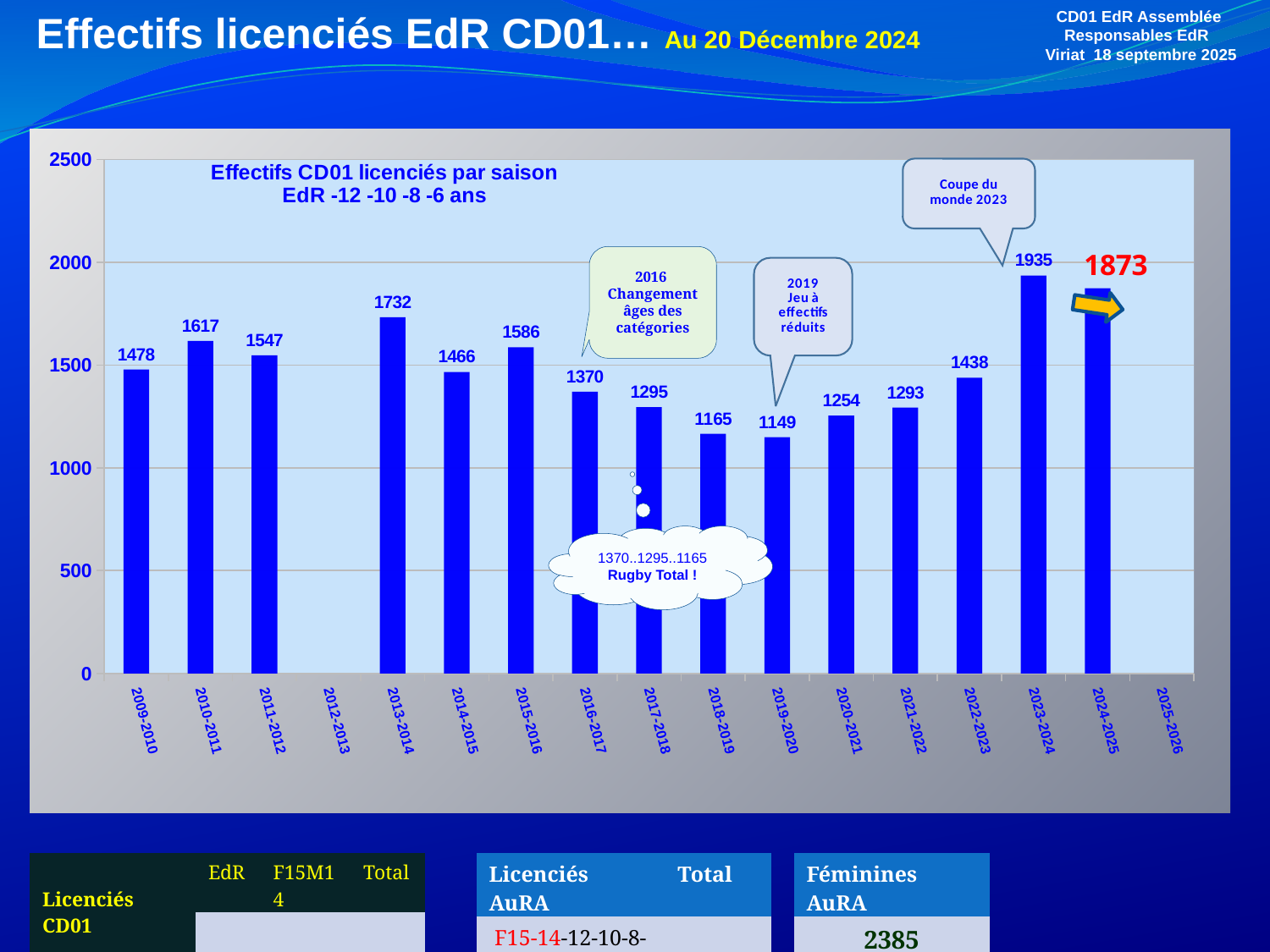
What is the title of the chart? Effectifs CD01 licenciés par saison EdR -12 -10 -8 -6 ans What is the difference between the values for 2023-2024 and 2024-2025? 62 What is the value for the 2013-2014 season? 1732 Which season has the highest value? 2023-2024 What is the difference between the values for 2013-2014 and 2014-2015? 266 Which is larger, the value for 2010-2011 or for 2011-2012? 2010-2011 What is the value for the 2019-2020 season? 1149 What is the value for the 2024-2025 season? 1873 Do the values rise or fall from 2019-2020 to 2023-2024? rise Is the value for 2022-2023 greater or less than 1500? less Which season has the lowest value? 2019-2020 What kind of chart is shown on the slide? bar chart